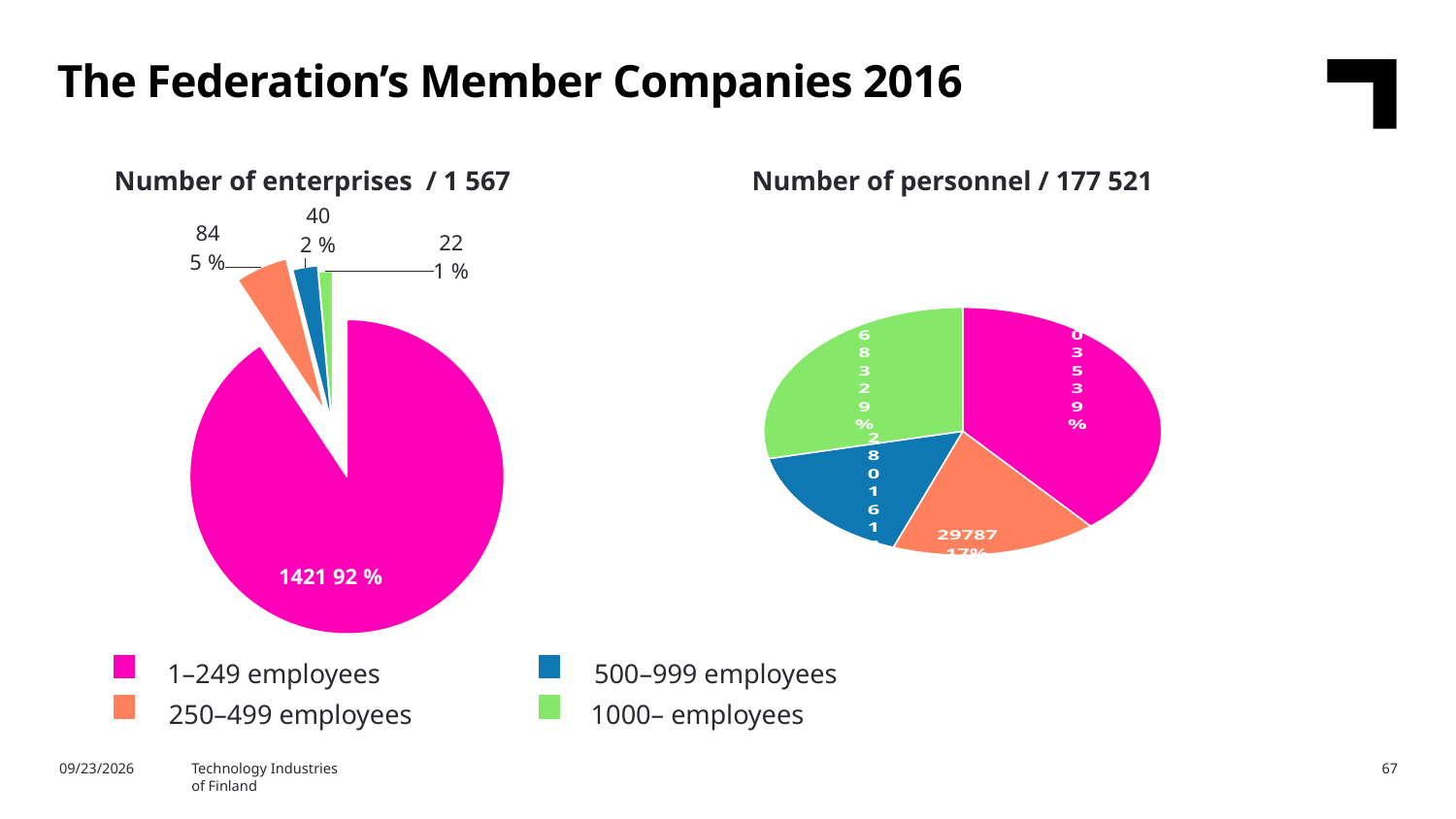
In the 'Number of enterprises / 1 567' chart, how many enterprises have 1000 or more employees? 22 What kind of chart is the 'Number of enterprises / 1 567' chart? pie chart In the 'Number of enterprises / 1 567' chart, what share of enterprises have 500–999 employees? 2 % In the 'Number of enterprises / 1 567' chart, how many enterprises have 1–249 employees? 1421 In the 'Number of enterprises / 1 567' chart, what share of enterprises have 1–249 employees? 92 % In the 'Number of enterprises / 1 567' chart, which size category has the most enterprises? 1–249 employees In the 'Number of enterprises / 1 567' chart, are there more enterprises with 250–499 employees or with 1000– employees? 250–499 employees In the 'Number of enterprises / 1 567' chart, how many enterprises have 250–499 employees? 84 In the 'Number of enterprises / 1 567' chart, which size category has the fewest enterprises? 1000– employees In the 'Number of enterprises / 1 567' chart, what is the difference between the number of enterprises with 250–499 employees and those with 500–999 employees? 44 How many size categories does the legend list? 4 In the 'Number of personnel / 177 521' chart, how many personnel are in the 250–499 employees category? 29787